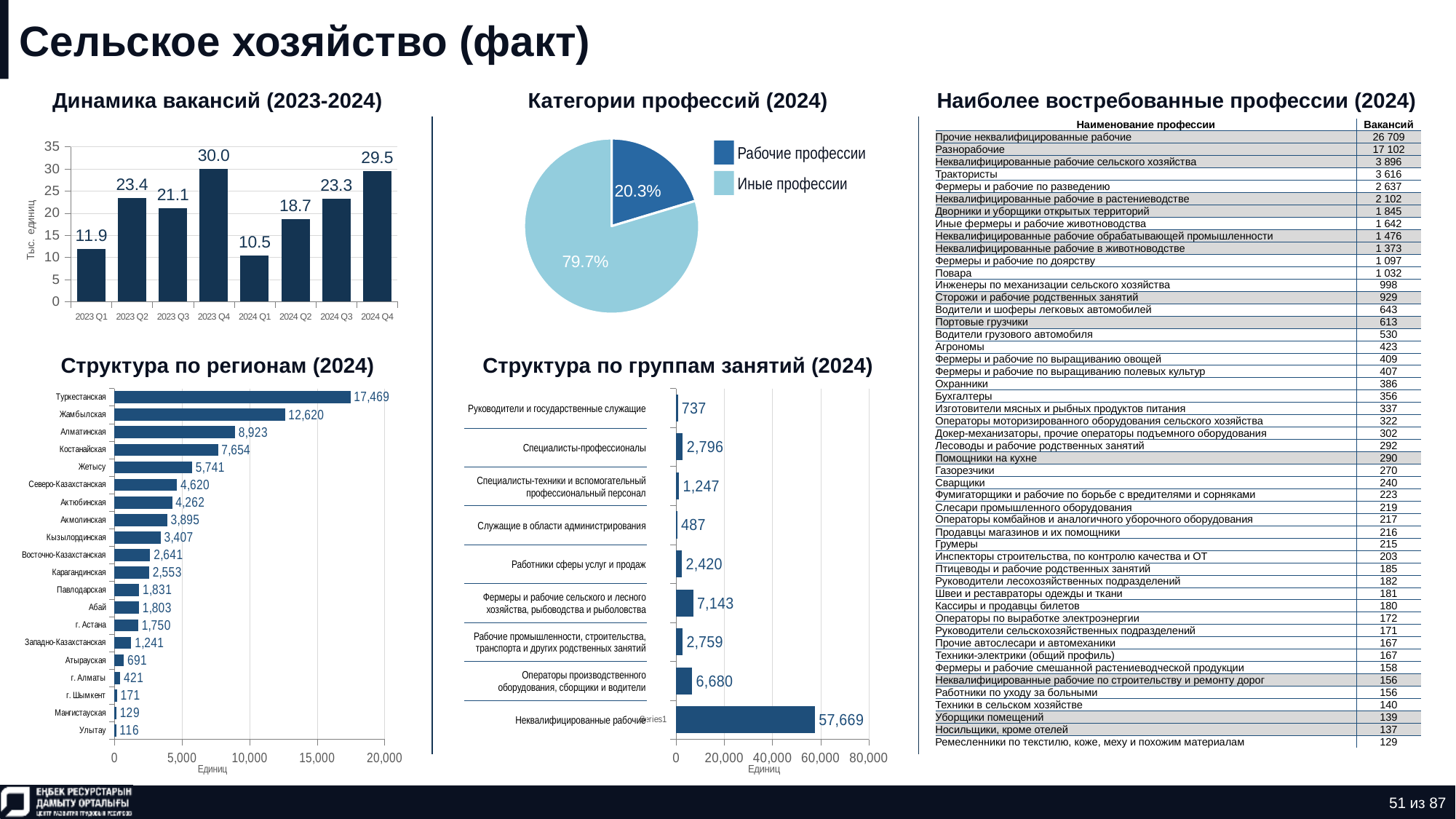
In the chart 'Динамика вакансий (2023-2024)', which quarter has the highest value? 2023 Q4 In the chart 'Структура по группам занятий (2024)', which category has the lowest value? Служащие в области администрирования In the chart 'Структура по регионам (2024)', which region has the highest value? Туркестанская In the chart 'Динамика вакансий (2023-2024)', what is the value for 2024 Q4? 29.5 In the chart 'Динамика вакансий (2023-2024)', what is the difference between the values for 2023 Q4 and 2024 Q1? 19.5 In the chart 'Структура по регионам (2024)', what is the value for Жамбылская? 12,620 In the chart 'Категории профессий (2024)', what share of the pie is 'Рабочие профессии'? 20.3% In the chart 'Структура по регионам (2024)', which is larger, Алматинская or Костанайская? Алматинская In the chart 'Динамика вакансий (2023-2024)', which quarter has the lowest value? 2024 Q1 In the chart 'Структура по группам занятий (2024)', what is the value for 'Работники сферы услуг и продаж'? 2,420 In the chart 'Динамика вакансий (2023-2024)', how many quarters are plotted? 8 What kind of chart is 'Категории профессий (2024)'? Pie chart